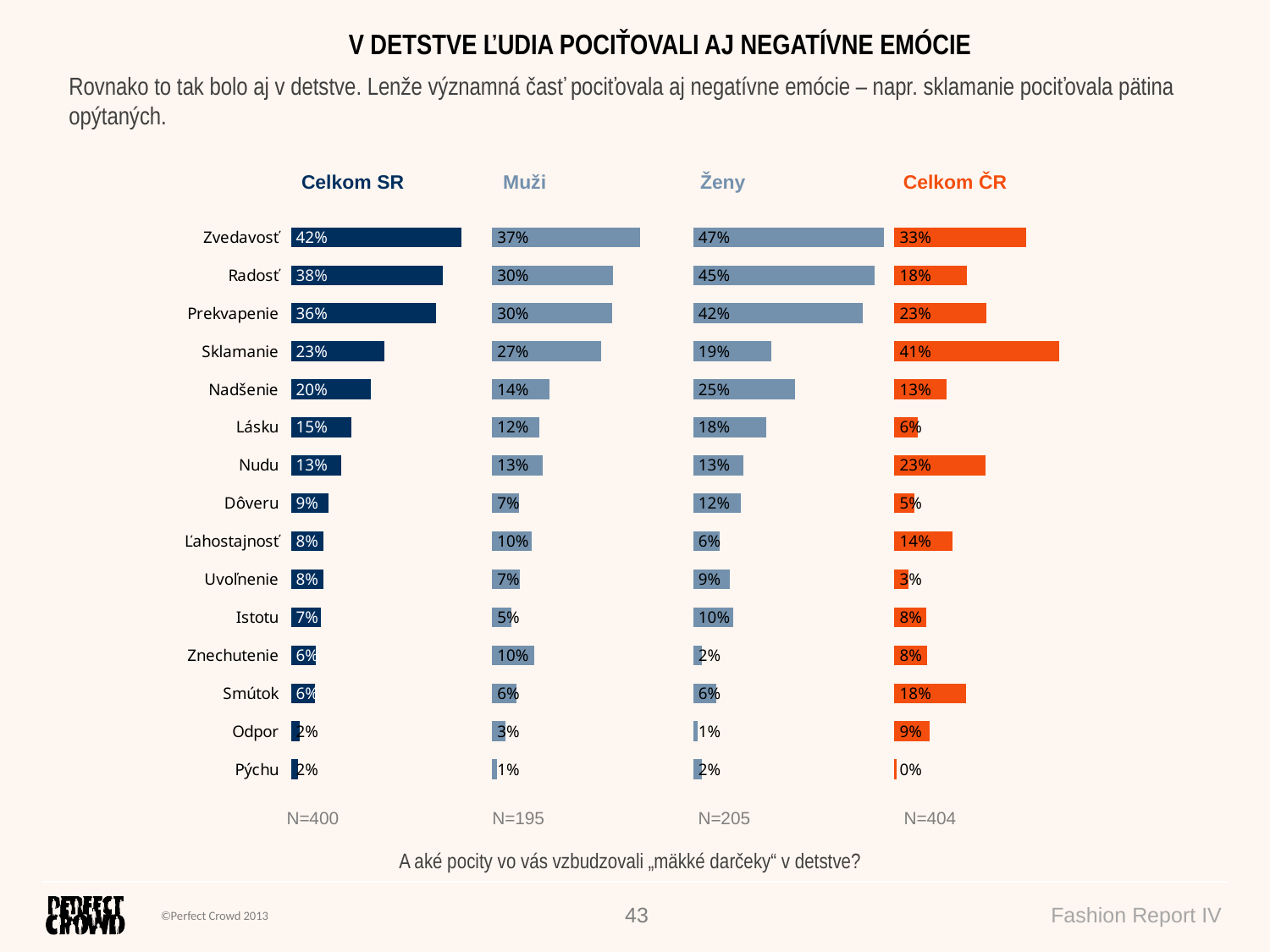
In the Muži chart, what is the difference between the values for Znechutenie and Smútok? 4% In the Celkom ČR chart, which category has the lowest value? Pýchu In the Celkom ČR chart, what is the value for Nudu? 23% In the Ženy chart, which is larger: the value for Nadšenie or the value for Lásku? Nadšenie In the Celkom SR chart, what is the value for Zvedavosť? 42% In the Ženy chart, what is the value for Radosť? 45% What sample size (N) is shown under the Ženy chart? N=205 What kind of chart is the Celkom ČR chart? Bar chart How many categories are shown in the Celkom SR chart? 15 In the Celkom ČR chart, what is the value for Sklamanie? 41% In the Muži chart, which category has the highest value? Zvedavosť In the Celkom SR chart, what is the difference between the values for Zvedavosť and Sklamanie? 19%